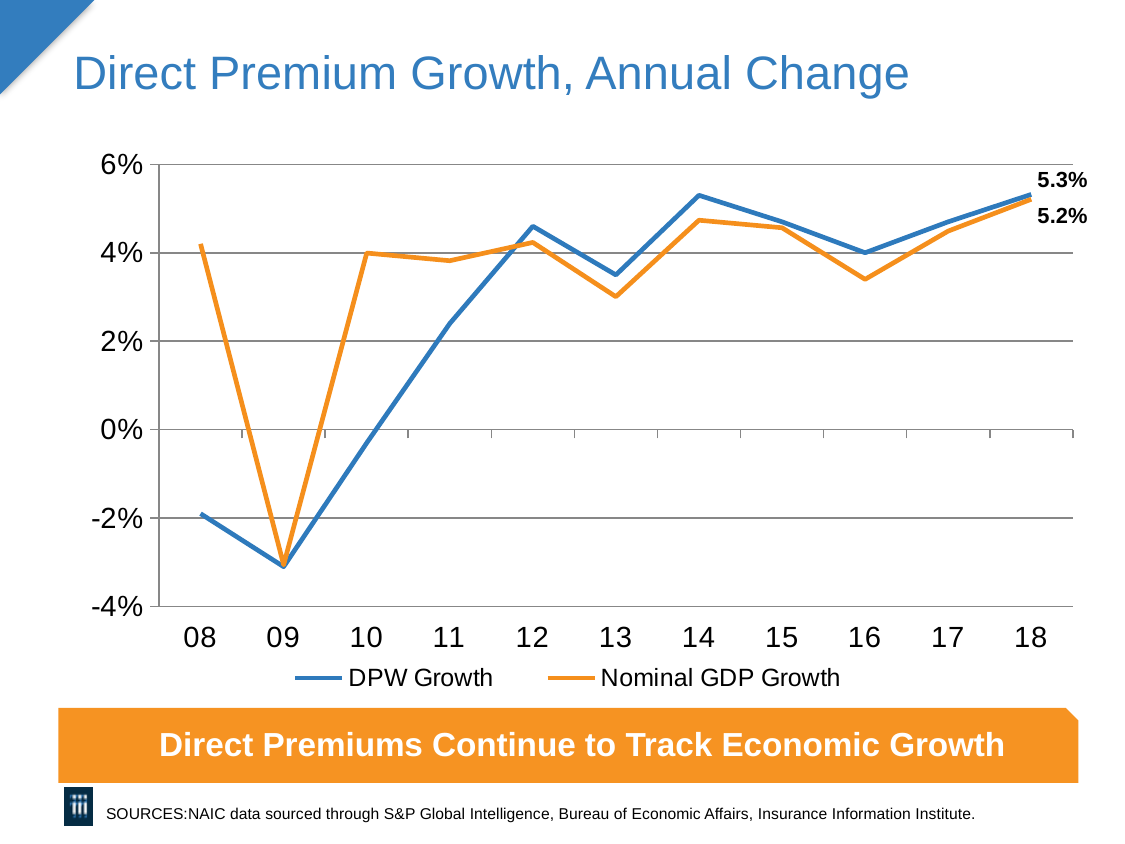
In 18, which series is higher, DPW Growth or Nominal GDP Growth? DPW Growth What is the difference between DPW Growth and Nominal GDP Growth in 18? 0.1 percentage points How many series does the legend list? 2 What is the DPW Growth value for 18? 5.3% Is the Nominal GDP Growth value for 13 greater or less than 2%? greater How many years are shown on the x axis? 11 Is the DPW Growth value for 14 greater or less than 4%? greater Is the DPW Growth value for 09 greater or less than -2%? less What kind of chart is shown on the slide? Line chart In which year is DPW Growth at its lowest? 09 In which year is Nominal GDP Growth at its highest? 18 What is the Nominal GDP Growth value for 18? 5.2%